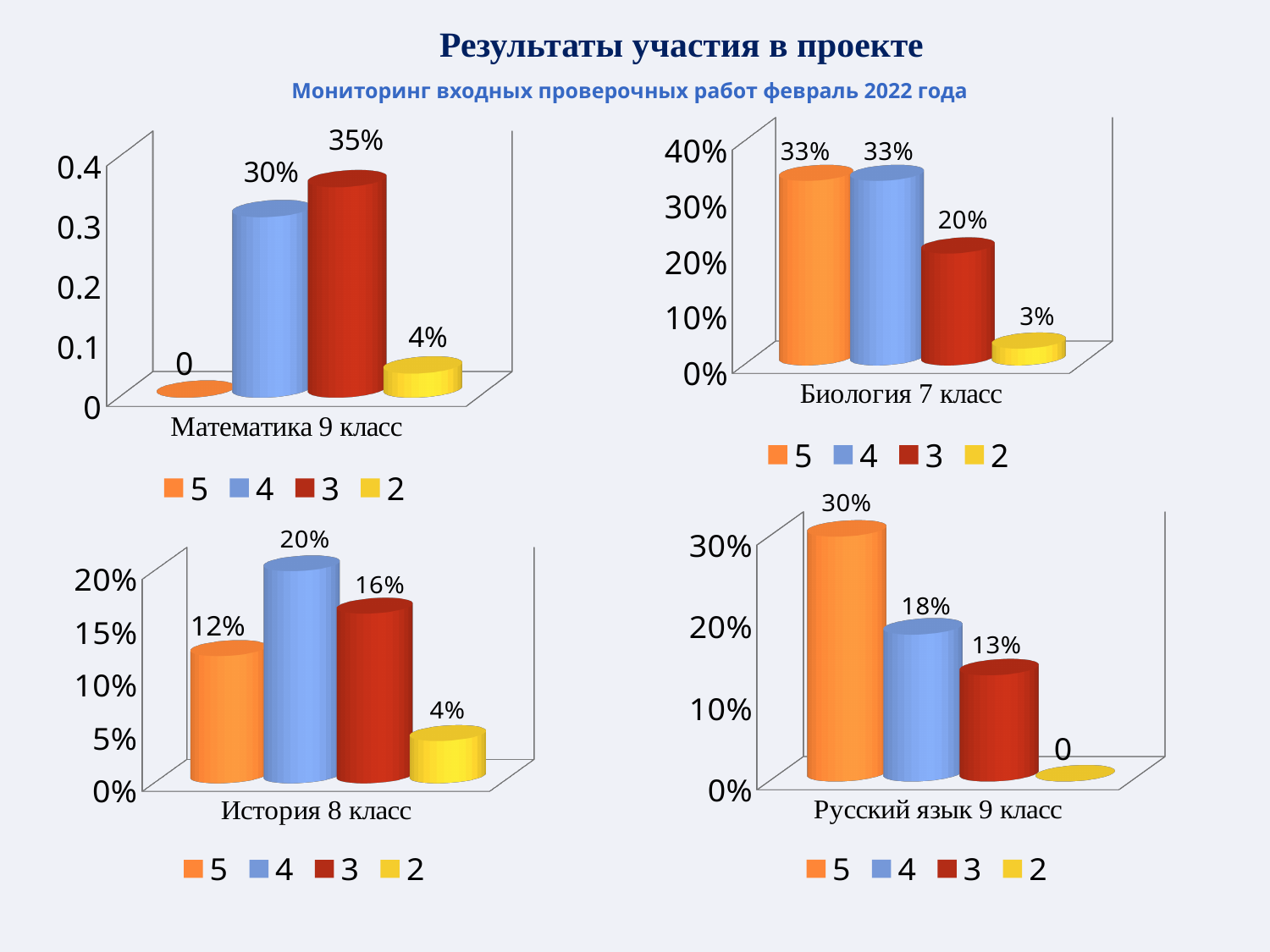
How many series does the legend of the 'Математика 9 класс' chart list? 4 How many charts are shown on the slide? 4 In the 'Математика 9 класс' chart, what is the value for grade 3? 35% In the 'Математика 9 класс' chart, what is the value for grade 5? 0 In the 'История 8 класс' chart, which is larger: the value for grade 3 or the value for grade 5? grade 3 In the 'История 8 класс' chart, which grade has the highest value? 4 In the 'Русский язык 9 класс' chart, what is the difference between the values for grade 5 and grade 4? 12% In the 'Русский язык 9 класс' chart, which grade has the lowest value? 2 What kind of chart is the 'История 8 класс' chart? bar chart In the 'Биология 7 класс' chart, what is the value for grade 2? 3% In the 'Русский язык 9 класс' chart, do the values rise or fall from grade 5 to grade 2? fall In the 'Биология 7 класс' chart, what is the difference between the values for grade 3 and grade 2? 17%